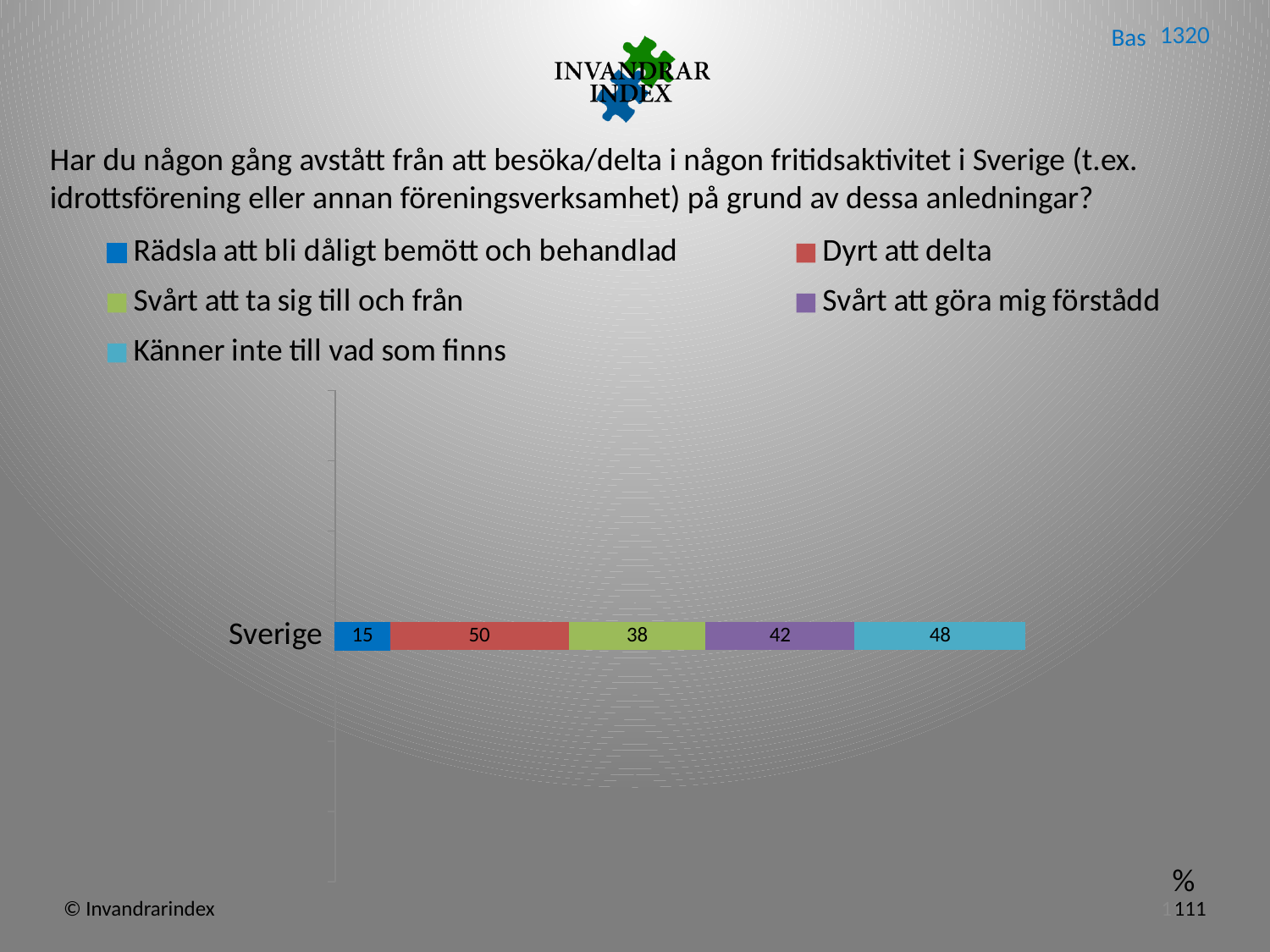
Which is larger for Sverige: "Känner inte till vad som finns" or "Svårt att göra mig förstådd"? Känner inte till vad som finns How many categories are shown on the chart? 1 What is the value for "Dyrt att delta" for Sverige? 50 What is the value for "Svårt att göra mig förstådd" for Sverige? 42 What is the value for "Rädsla att bli dåligt bemött och behandlad" for Sverige? 15 What kind of chart is shown on the slide? Stacked bar chart What is the total of the stacked bar for Sverige? 193 Which series has the lowest value for Sverige? Rädsla att bli dåligt bemött och behandlad What is the value for "Känner inte till vad som finns" for Sverige? 48 How many series does the legend list? 5 Which series has the highest value for Sverige? Dyrt att delta What is the difference between "Dyrt att delta" and "Svårt att ta sig till och från" for Sverige? 12